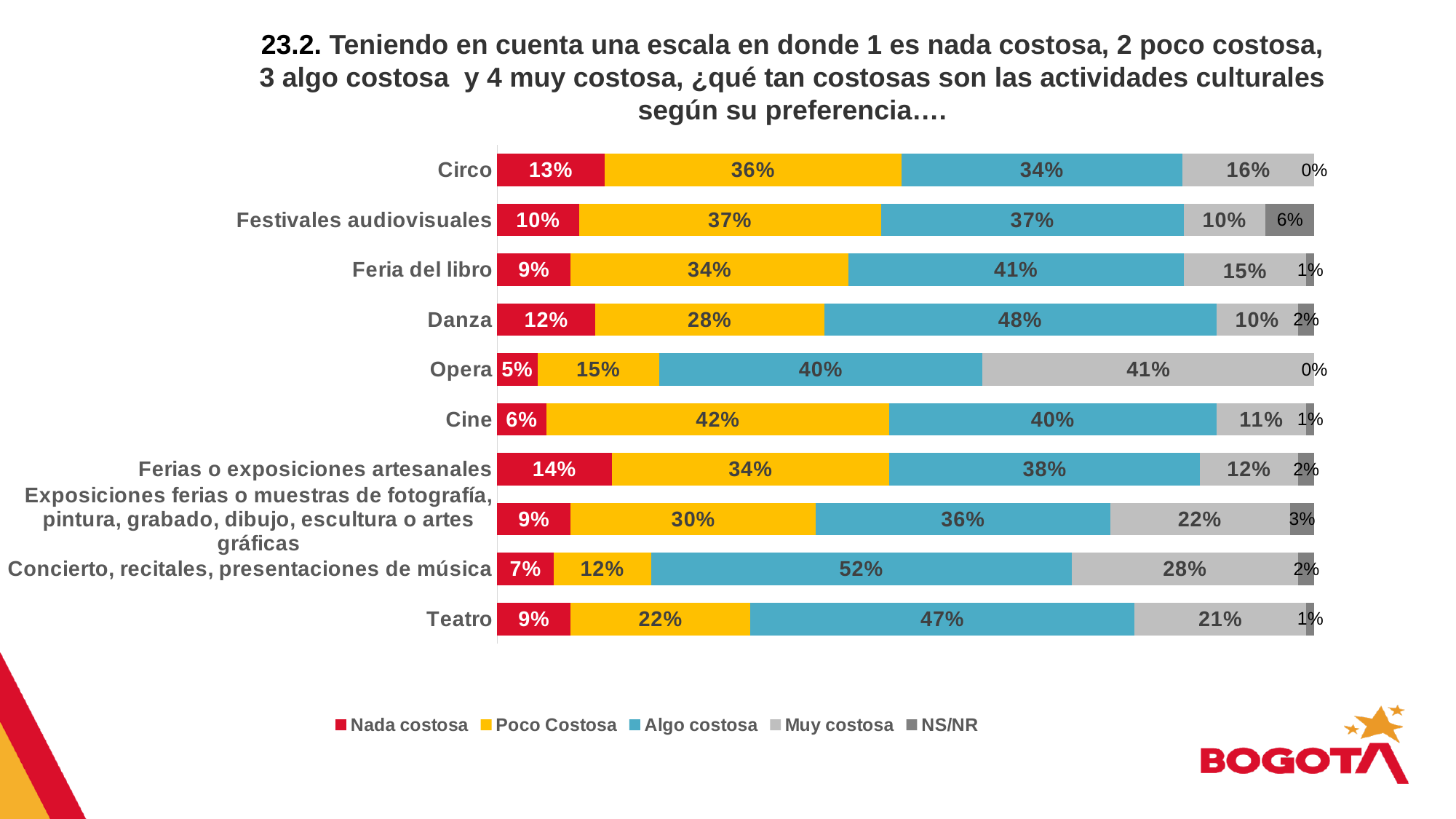
What kind of chart is shown on the slide? Stacked bar chart What is the value for Muy costosa for Opera? 41% Which has a larger Muy costosa value, Concierto, recitales, presentaciones de música or Circo? Concierto, recitales, presentaciones de música Which category has the highest Algo costosa value? Concierto, recitales, presentaciones de música How many categories are shown in the chart? 10 What is the difference between the Poco Costosa values for Cine and Teatro? 20 percentage points What colour represents Nada costosa in the legend? Red Which category has the lowest Nada costosa value? Opera What is the NS/NR value for Festivales audiovisuales? 6% What is the value for Algo costosa for Danza? 48% Which category has the highest Poco Costosa value? Cine How many series does the legend list? 5